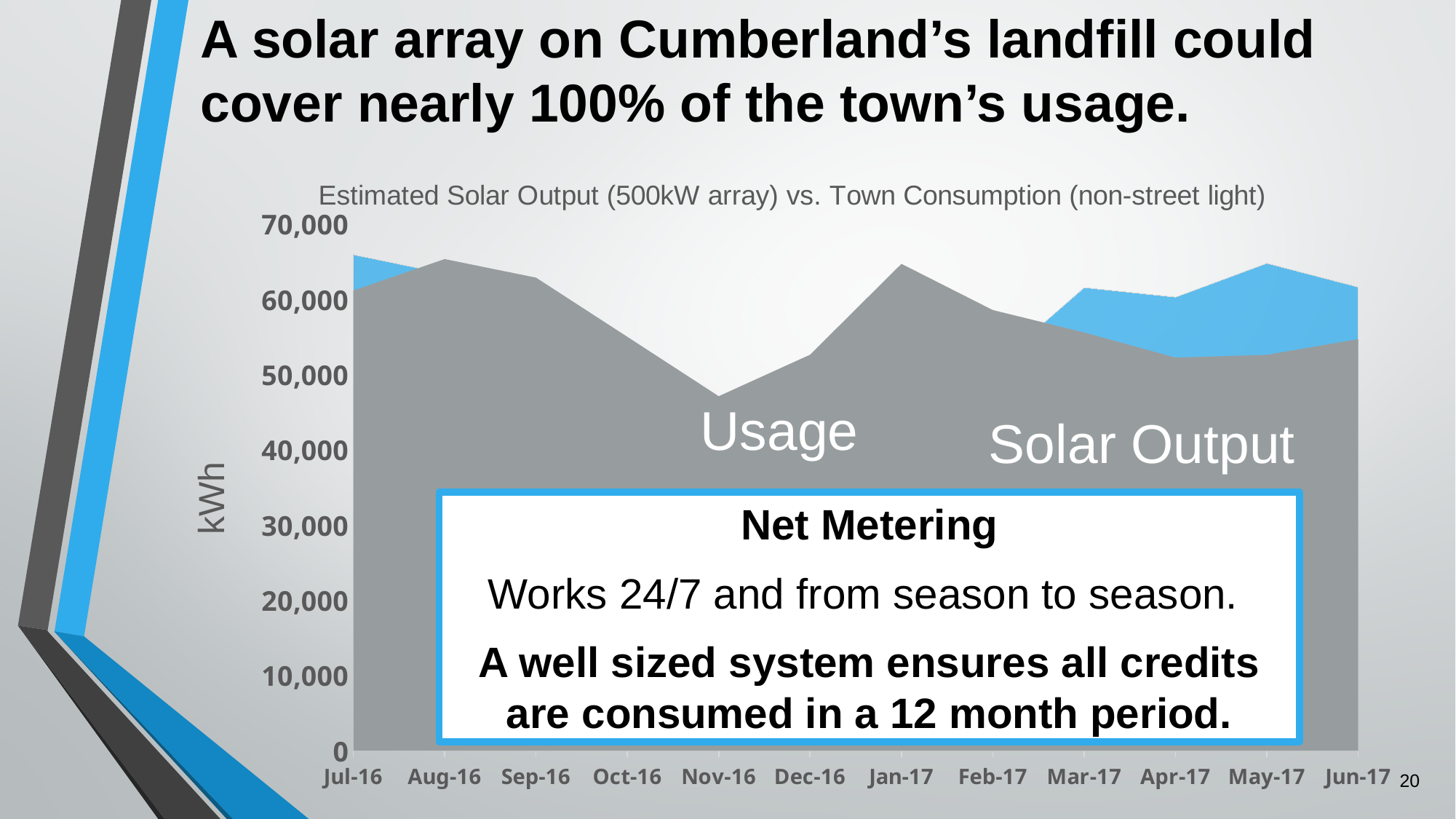
Is the Solar Output value for Jul-16 greater or less than 60,000? greater How many months are shown along the x axis of the chart? 12 What unit is shown on the y axis of the chart? kWh In May-17, which is larger, Solar Output or Usage? Solar Output In which month is Usage lowest? Nov-16 Is the Solar Output value for May-17 greater or less than 60,000? greater What kind of chart is shown on the slide? area chart Does Usage rise or fall from Aug-16 to Nov-16? fall Is the Usage value for Nov-16 greater or less than 50,000? less What is the title of the chart? Estimated Solar Output (500kW array) vs. Town Consumption (non-street light) How many data series does the chart plot? 2